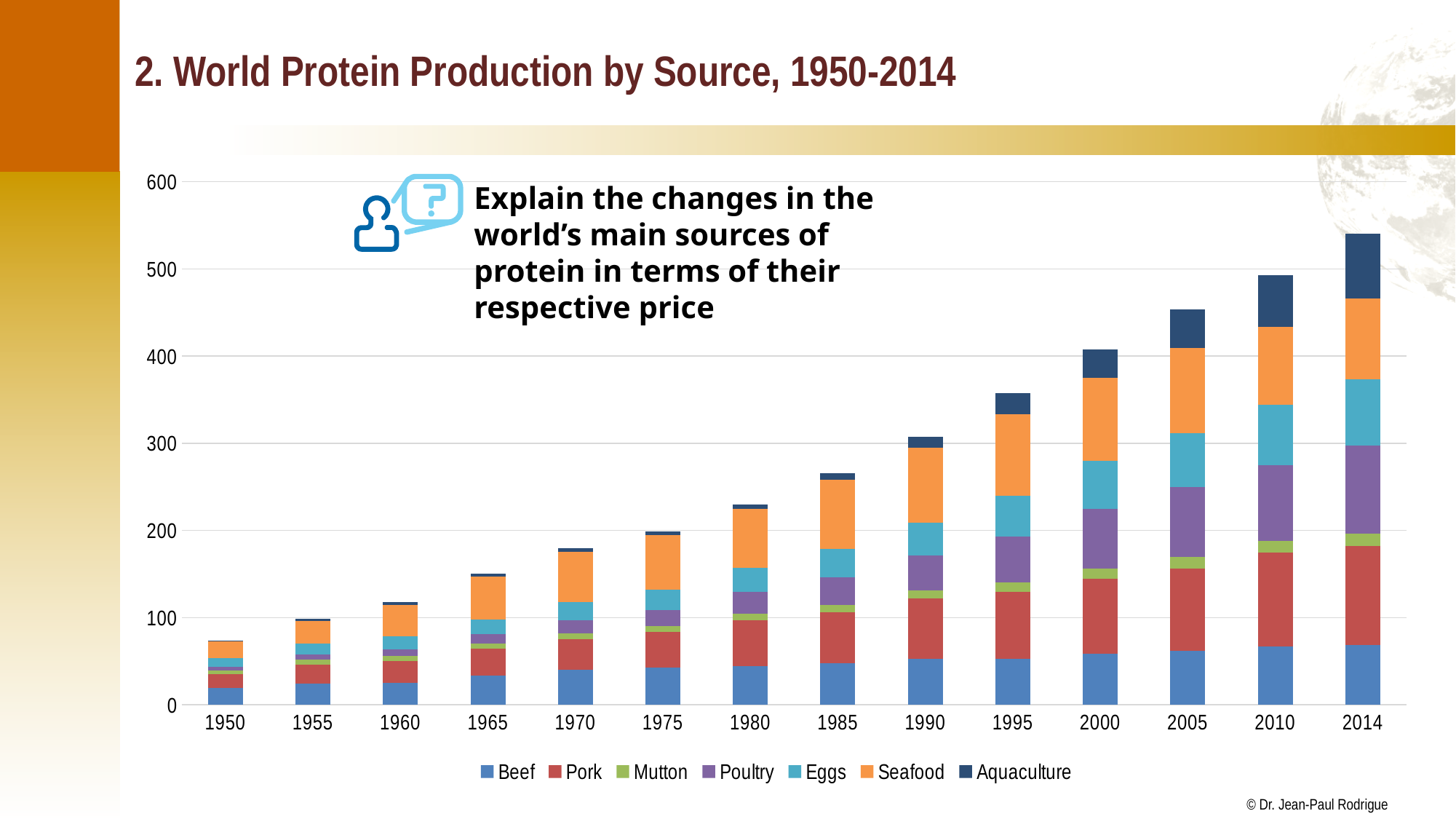
Which year has the highest total protein production in the chart? 2014 How many series does the chart's legend list? 7 Is the total value for 1950 greater or less than 100? less Which year has the larger total bar, 2005 or 2010? 2010 Which series is listed last in the chart's legend? Aquaculture Do the total bar heights rise or fall from 1950 to 2014? rise Is the total value for 2005 greater or less than 400? greater What kind of chart is shown on the slide? stacked bar chart Which year has the lowest total protein production in the chart? 1950 Is the total value for 1985 greater or less than 300? less How many years are shown along the x axis of the chart? 14